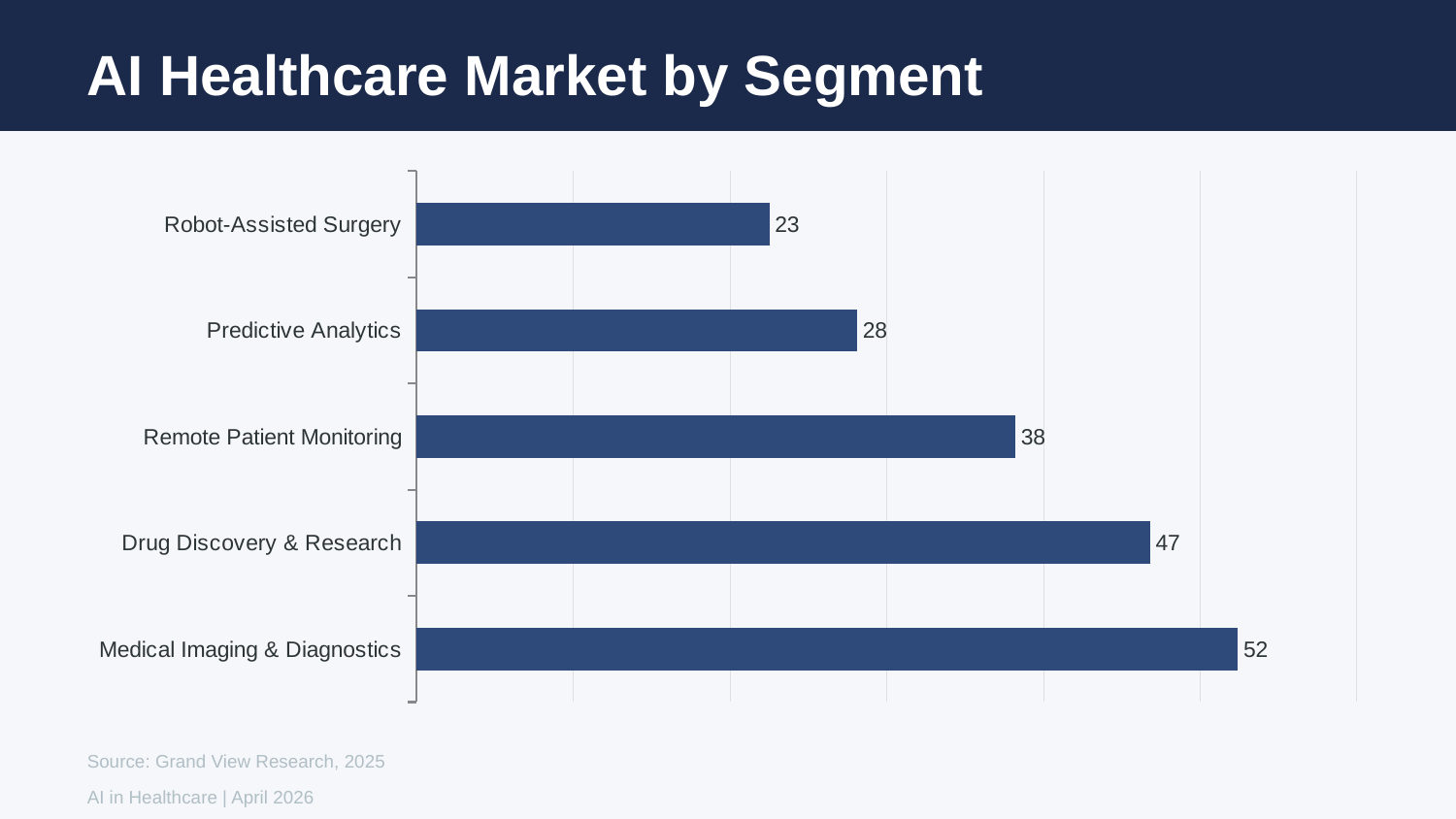
What is the difference between the values for Remote Patient Monitoring and Predictive Analytics? 10 What is the value for Medical Imaging & Diagnostics? 52 What is the title of the chart? AI Healthcare Market by Segment What is the value for Predictive Analytics? 28 What is the difference between the values for Medical Imaging & Diagnostics and Drug Discovery & Research? 5 Which segment has the lowest value? Robot-Assisted Surgery Which is larger, the value for Drug Discovery & Research or the value for Remote Patient Monitoring? Drug Discovery & Research How many segments are shown in the chart? 5 What kind of chart is shown on the slide? Bar chart What is the value for Robot-Assisted Surgery? 23 Which segment has the highest value? Medical Imaging & Diagnostics What is the value for Remote Patient Monitoring? 38